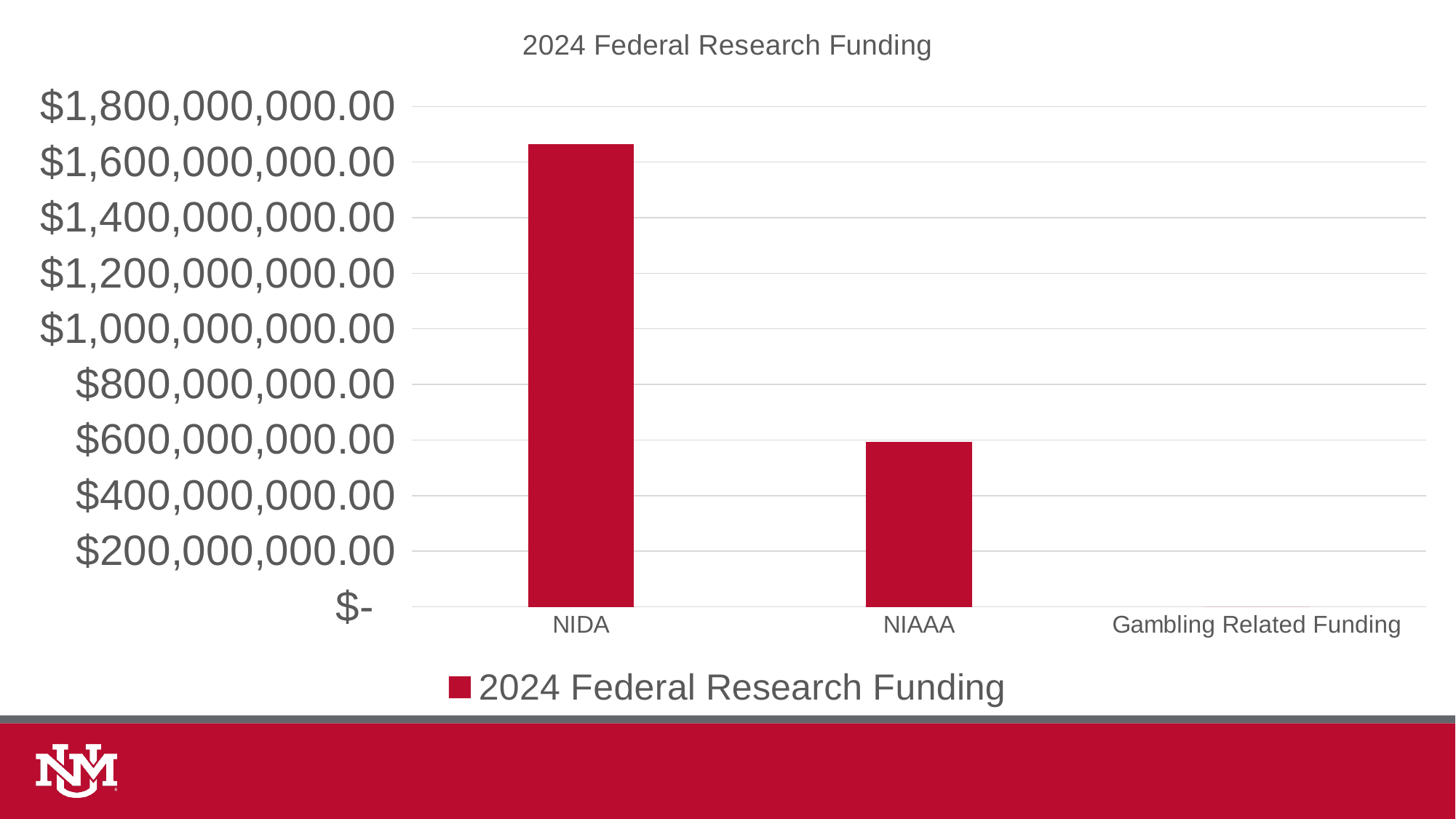
What is the title of the chart? 2024 Federal Research Funding Which category has the lowest 2024 Federal Research Funding? Gambling Related Funding What kind of chart is shown on the slide? bar chart How many series does the legend list? 1 Which category has the highest 2024 Federal Research Funding? NIDA Is the value for NIDA greater or less than $1,600,000,000.00? greater How many categories are shown on the x axis of the chart? 3 What is the name of the series shown in the legend? 2024 Federal Research Funding Is the value for NIAAA greater or less than $800,000,000.00? less Is the value for NIAAA greater or less than $400,000,000.00? greater Which has more 2024 Federal Research Funding, NIDA or NIAAA? NIDA